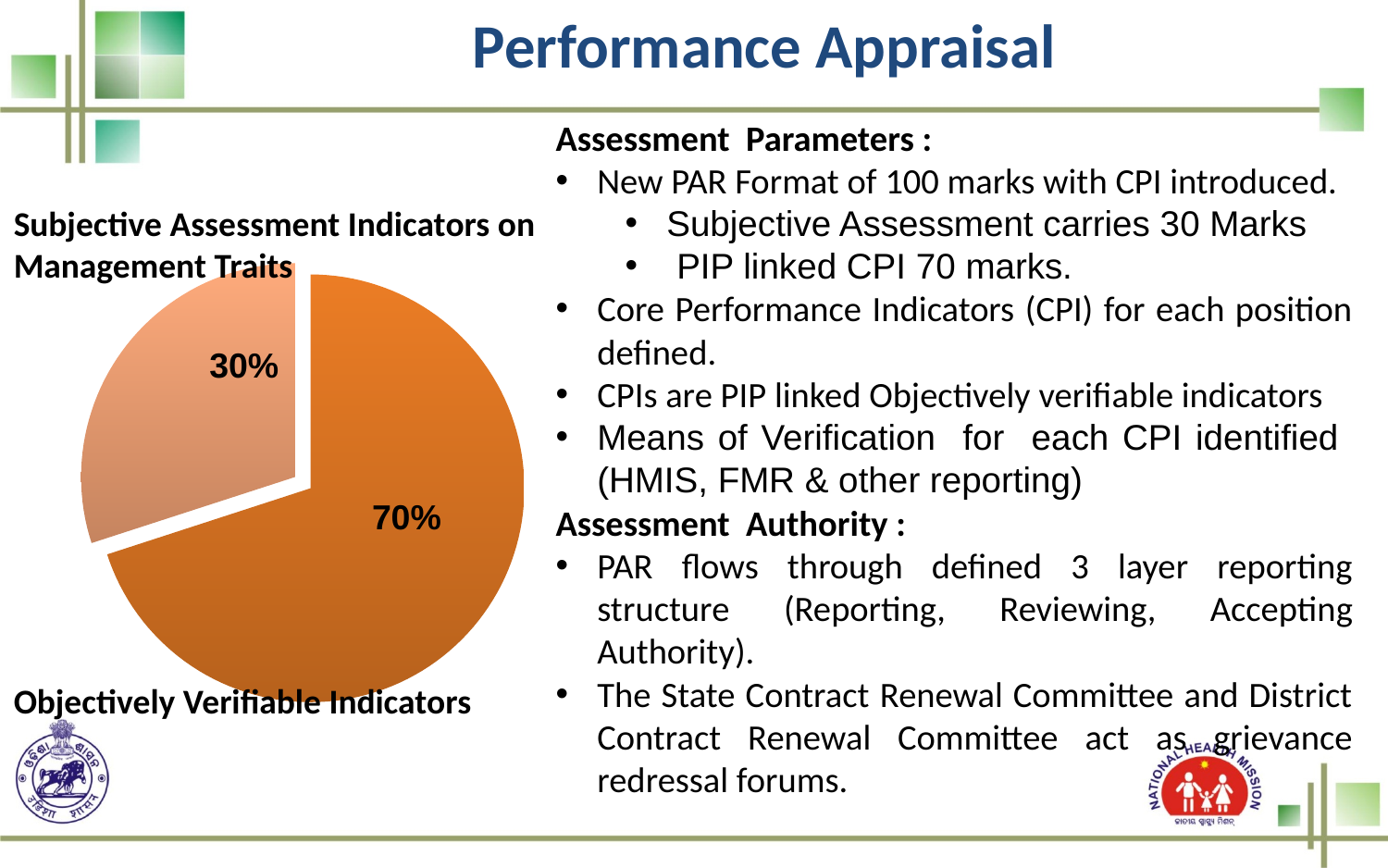
Which is larger: the Subjective Assessment Indicators slice or the Objectively Verifiable Indicators slice? Objectively Verifiable Indicators What share of the pie is labelled for Objectively Verifiable Indicators? 70% How many slices does the pie chart have? 2 What share of the pie is labelled for Subjective Assessment Indicators on Management Traits? 30% Which slice of the pie chart is the largest? Objectively Verifiable Indicators What colour is the 70% slice of the pie chart? orange What is the total of the two percentages shown on the pie chart? 100% Which slice of the pie chart is the smallest? Subjective Assessment Indicators on Management Traits Which slice of the pie chart is pulled out (exploded) from the rest? Subjective Assessment Indicators on Management Traits (30%) What is the difference in percentage points between the Objectively Verifiable Indicators slice and the Subjective Assessment Indicators slice? 40 What kind of chart is shown on the slide? pie chart